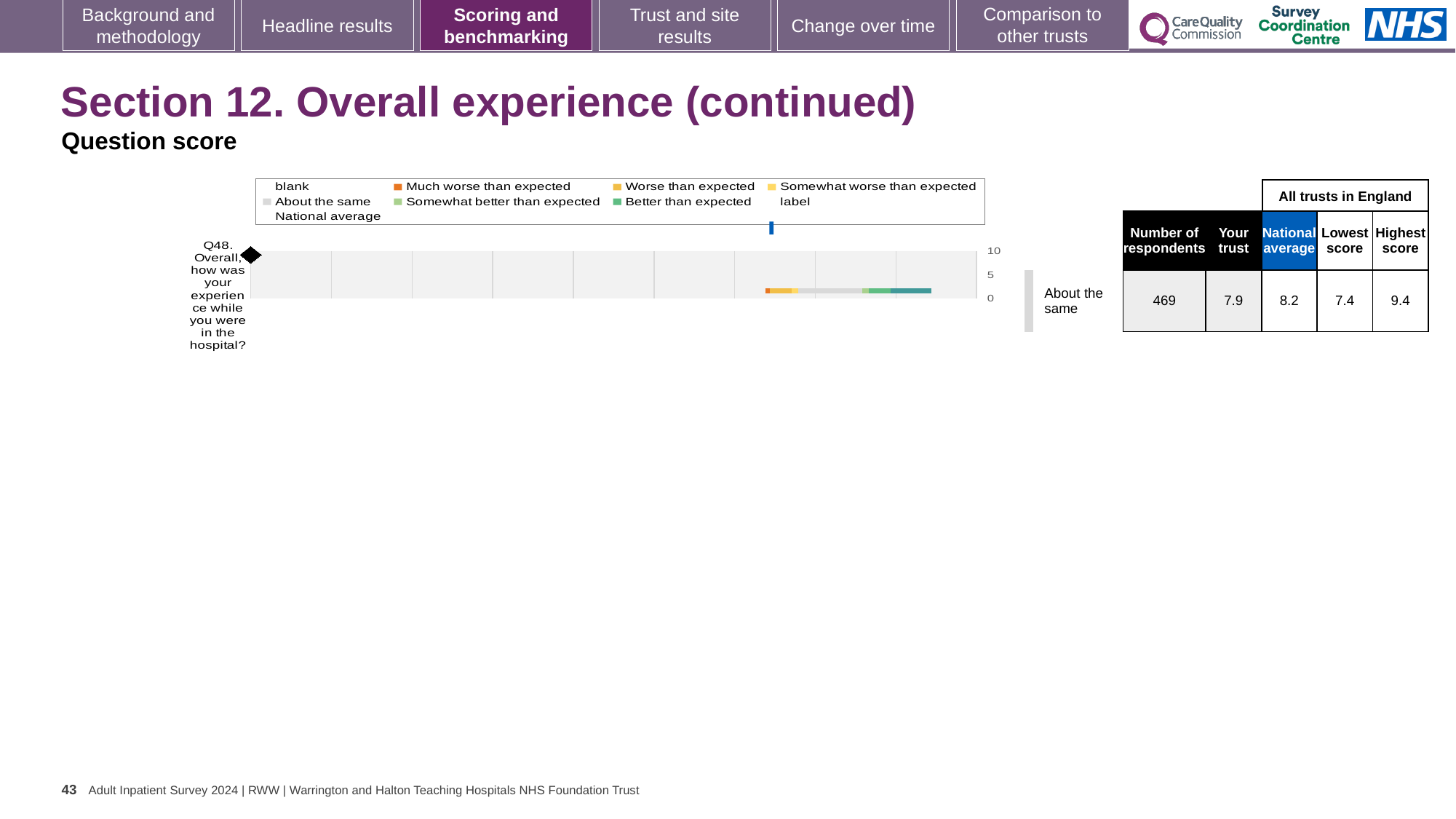
What is the difference between the highest score and the lowest score for Q48? 2.0 How many respondents answered Q48? 469 What kind of chart is shown on the slide? bar chart How many questions are plotted in the chart? 1 What is the difference between the national average and the 'Your trust' score for Q48? 0.3 What benchmarking category is the trust's Q48 result labelled as? About the same What is the lowest score among all trusts in England for Q48? 7.4 What is the 'Your trust' score for Q48? 7.9 What is the national average score for Q48? 8.2 Which question is plotted in the chart? Q48. Overall, how was your experience while you were in the hospital? Which is larger for Q48, the 'Your trust' score or the national average? National average What is the highest score among all trusts in England for Q48? 9.4